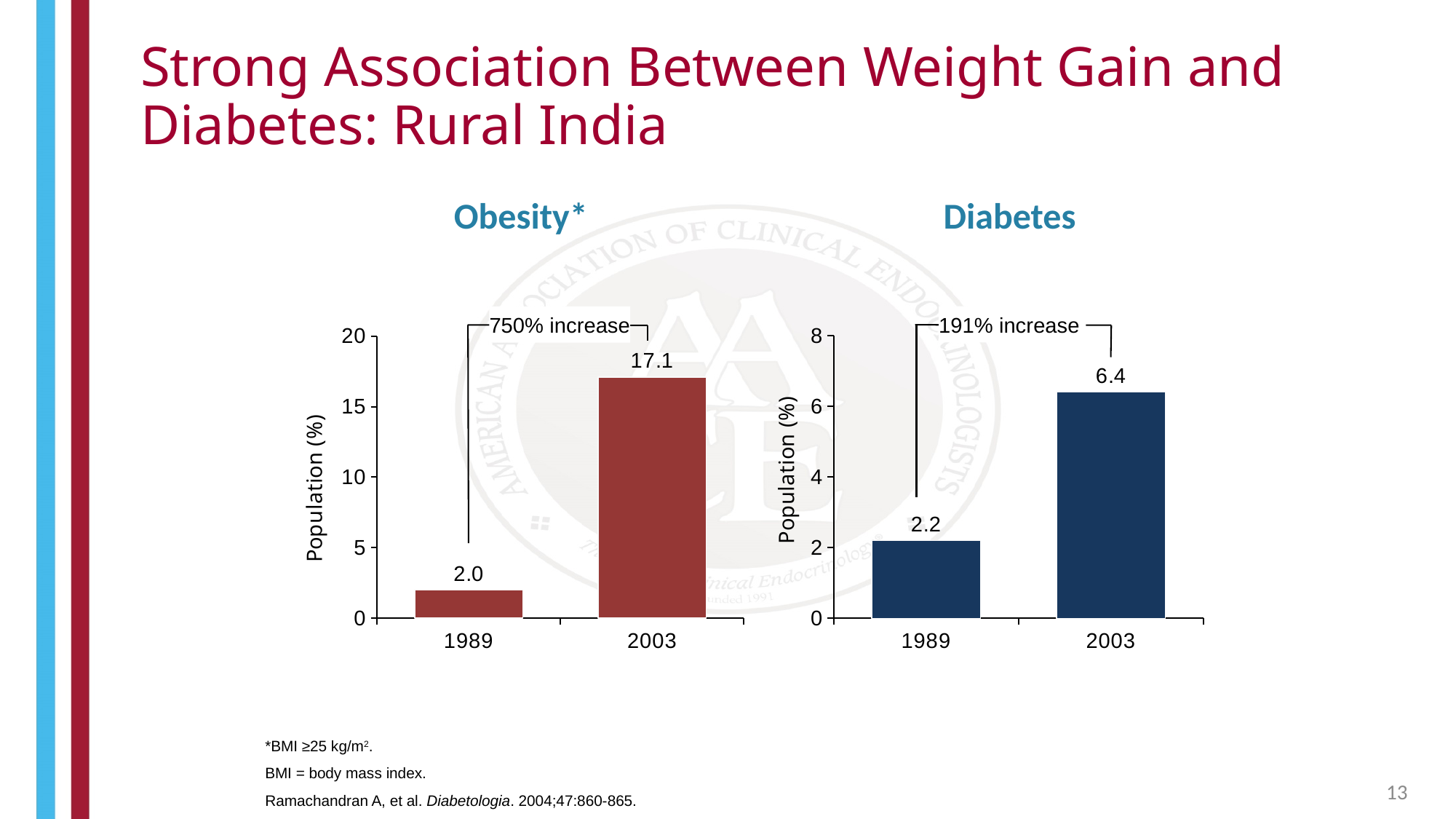
In the Obesity chart, which year has the higher value? 2003 In the Obesity chart, what is the difference between the 2003 and 1989 values? 15.1 In the Obesity chart, what is the value for 2003? 17.1 In the Diabetes chart, what is the value for 2003? 6.4 Is the 2003 value in the Obesity chart greater or less than 15? greater In the Diabetes chart, what is the value for 1989? 2.2 In the Diabetes chart, what is the difference between the 2003 and 1989 values? 4.2 In the Obesity chart, what is the value for 1989? 2.0 How many bars are shown in the Diabetes chart? 2 What percentage increase is annotated on the Diabetes chart? 191% increase What kind of chart is the Obesity chart? Bar chart In the Diabetes chart, which year has the lower value? 1989